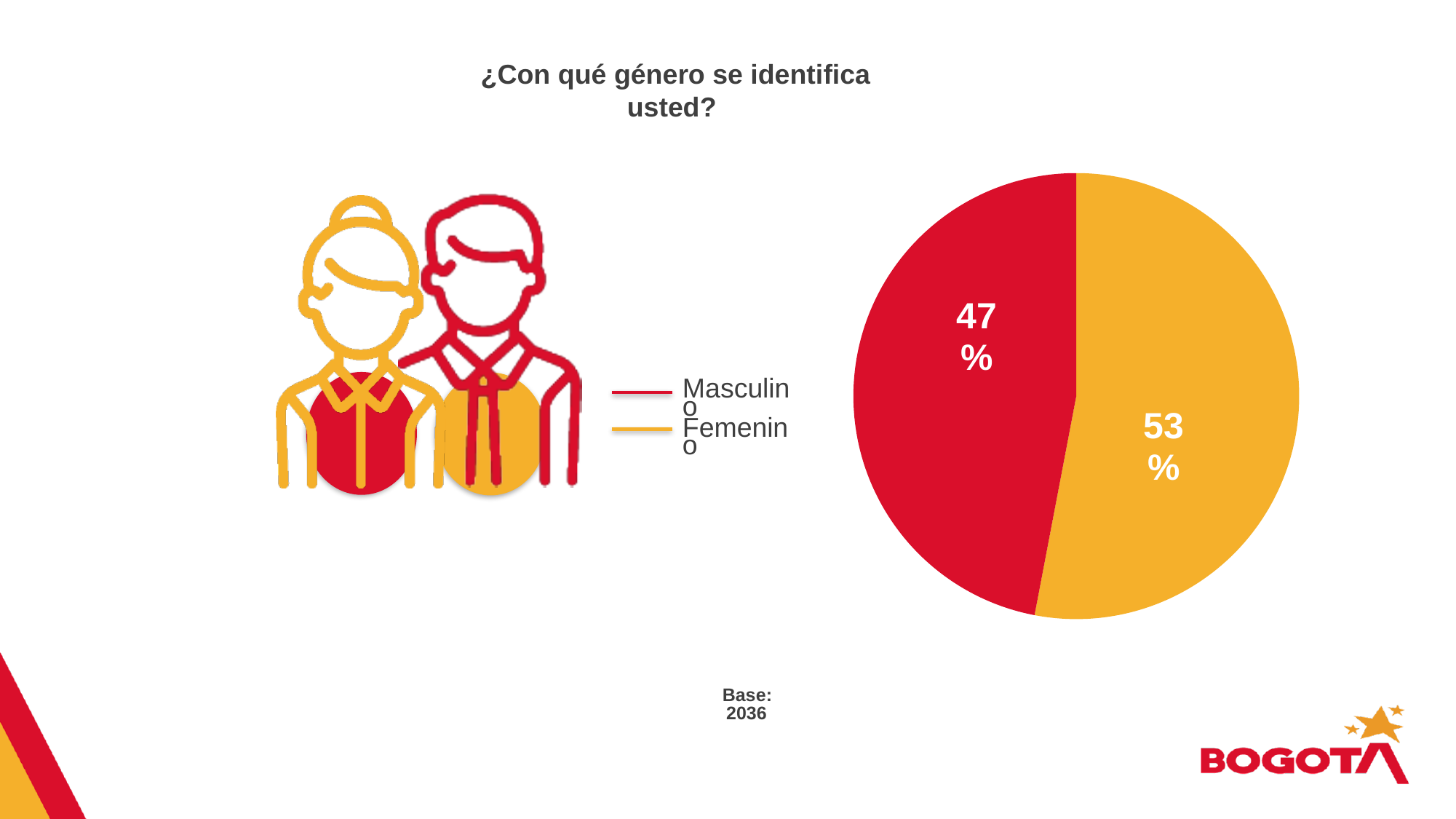
What kind of chart is shown on the slide? pie chart What colour represents Masculino in the pie chart? red Which gender category has the largest share of the pie? Femenino What is the base (number of respondents) shown on the slide? 2036 Which is larger, the share for Masculino or the share for Femenino? Femenino What percentage of respondents identified as Masculino? 47% How many categories does the pie chart show? 2 Which gender category has the smallest share of the pie? Masculino What percentage of respondents identified as Femenino? 53% How many entries does the legend list? 2 What is the difference in percentage points between Femenino and Masculino? 6 What is the title of the chart? ¿Con qué género se identifica usted?